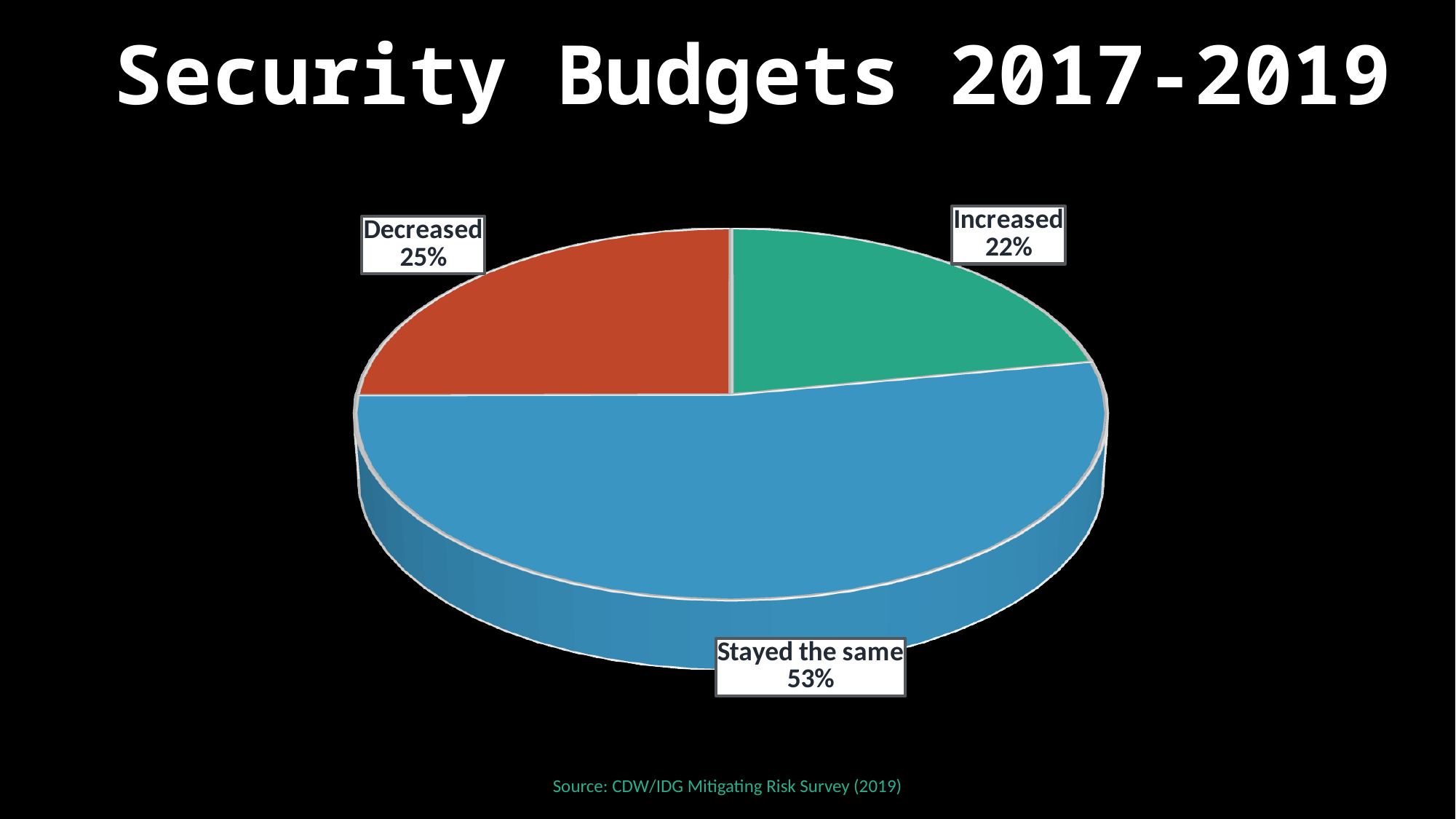
How many slices does the pie chart have? 3 What kind of chart is shown on the slide? Pie chart Which category has the largest share of the pie? Stayed the same What is the difference in percentage points between 'Stayed the same' and 'Decreased'? 28 What percentage of security budgets increased? 22% What percentage of security budgets decreased? 25% Which is larger, the share for 'Decreased' or the share for 'Increased'? Decreased What is the title of the slide? Security Budgets 2017-2019 What colour is the 'Decreased' slice? Red Which category has the smallest share of the pie? Increased What percentage of security budgets stayed the same? 53% What is the difference in percentage points between 'Decreased' and 'Increased'? 3